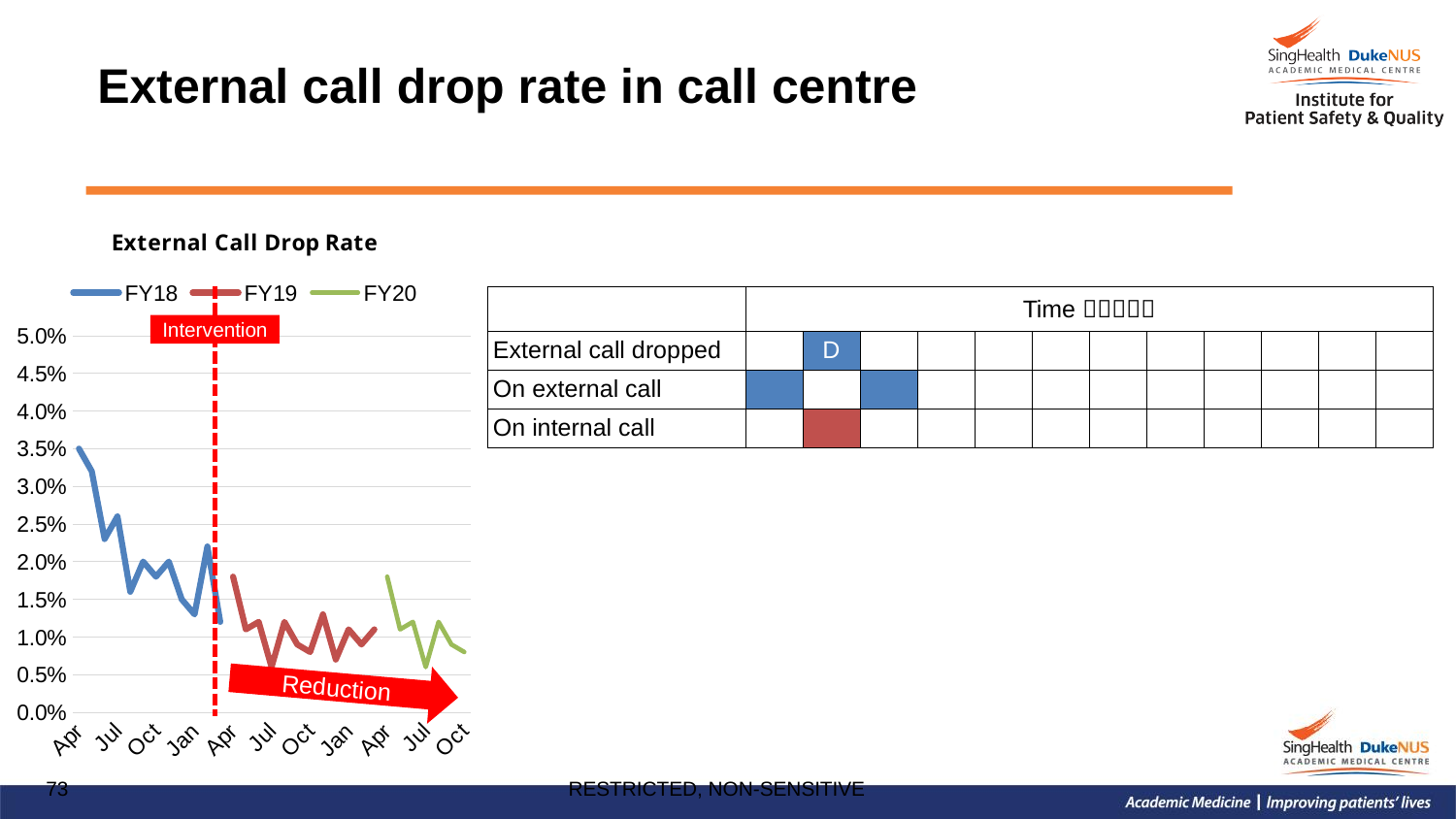
Is the first FY18 value (Apr) in the "External Call Drop Rate" chart greater or less than 3.0%? greater Are the FY19 values in the "External Call Drop Rate" chart greater or less than 2.0%? less In the "External Call Drop Rate" chart, which is larger: the first FY18 value or the last FY20 value? the first FY18 value Does the FY18 line in the "External Call Drop Rate" chart generally rise or fall from Apr to the following Apr? fall What kind of chart is the "External Call Drop Rate" chart? line chart What are the series names shown in the legend of the "External Call Drop Rate" chart? FY18, FY19, FY20 Which series in the "External Call Drop Rate" chart reaches the highest value? FY18 Are all FY20 values in the "External Call Drop Rate" chart greater or less than 2.0%? less How many series does the legend of the "External Call Drop Rate" chart list? 3 What is the highest value shown on the y axis of the "External Call Drop Rate" chart? 5.0% What is the title of the line chart on the slide? External Call Drop Rate